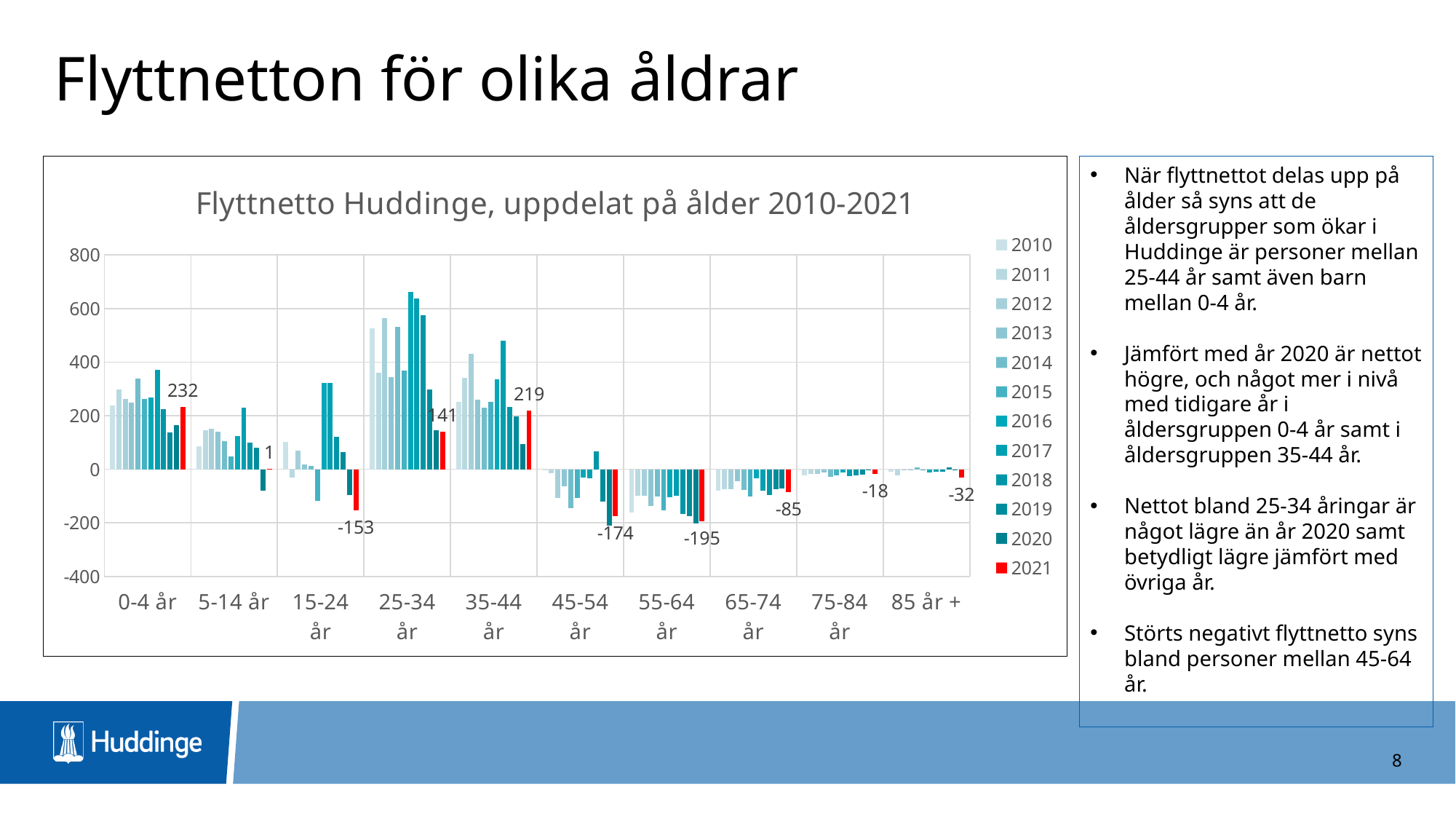
What is the 2021 value for the 0-4 år age group? 232 How many age groups are shown on the x axis? 10 Which age group has the lowest 2021 value? 55-64 år Which is larger in 2021: the value for 45-54 år or for 55-64 år? 45-54 år What is the 2021 value for the 35-44 år age group? 219 How many series does the legend list? 12 What is the 2021 value for the 5-14 år age group? 1 What is the 2021 value for the 15-24 år age group? -153 What is the 2021 value for the 55-64 år age group? -195 What type of chart is shown? Bar chart Which age group has the highest 2021 value? 0-4 år What is the difference between the 2021 values for 0-4 år and 35-44 år? 13